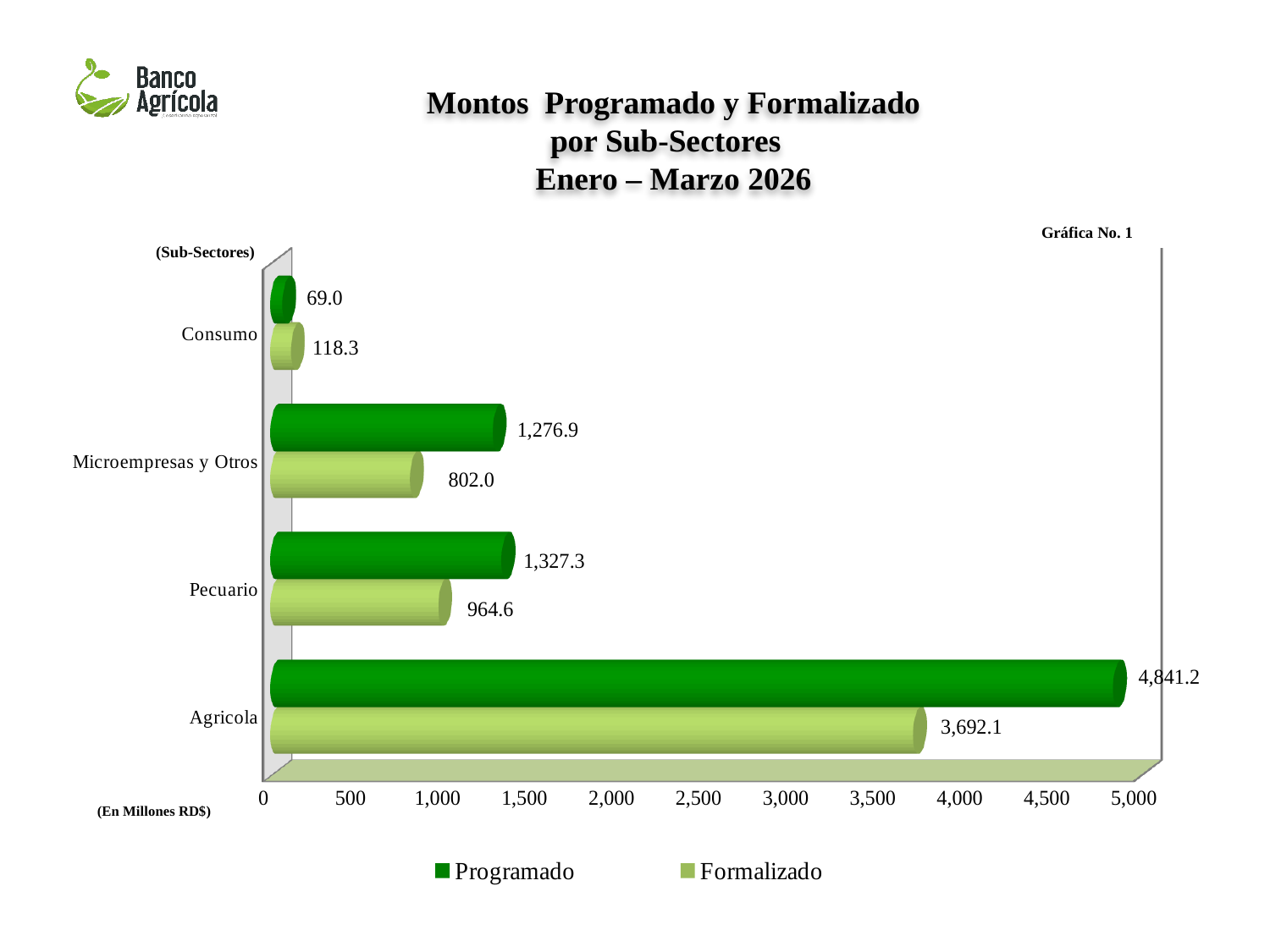
How many series does the legend list? 2 What is the Programado value for Agricola? 4,841.2 What is the difference between the Programado and Formalizado values for Pecuario? 362.7 What is the Formalizado value for Consumo? 118.3 What kind of chart is shown on the slide? Bar chart What is the Programado value for Microempresas y Otros? 1,276.9 What is the difference between the Programado and Formalizado values for Agricola? 1,149.1 Which sub-sector has the lowest Formalizado value? Consumo Which sub-sector has the highest Programado value? Agricola How many sub-sectors are shown on the chart? 4 For Consumo, which is larger: the Programado value or the Formalizado value? Formalizado What is the Formalizado value for Pecuario? 964.6